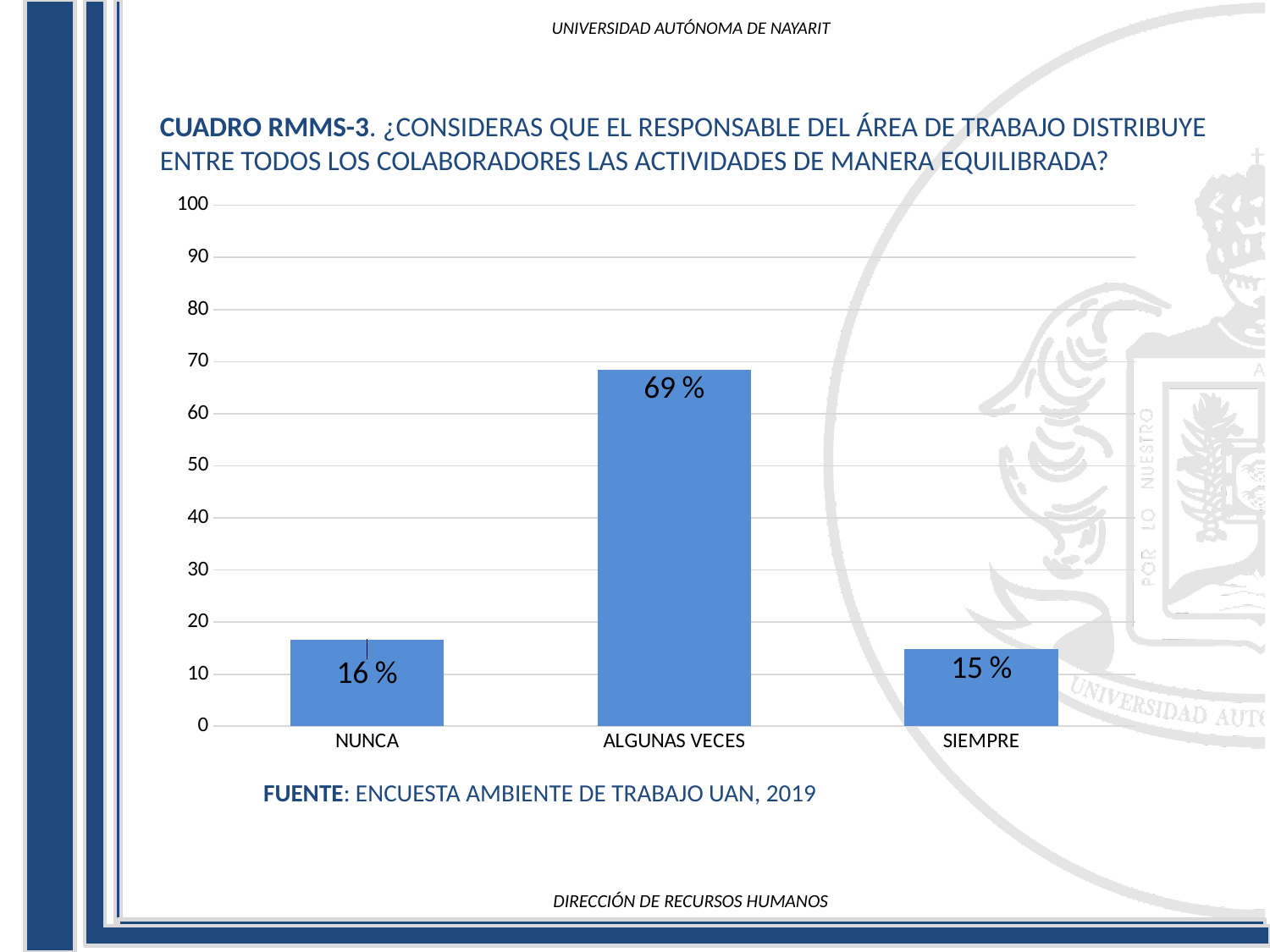
What is the difference between the values for NUNCA and SIEMPRE? 1 % How many categories are shown on the x axis? 3 What is the value for NUNCA? 16 % Which category has the highest value? ALGUNAS VECES What kind of chart is shown on the slide? bar chart What is the difference between the values for ALGUNAS VECES and NUNCA? 53 % Is the value for ALGUNAS VECES greater or less than 60? greater What is the highest value shown on the y axis? 100 What is the value for SIEMPRE? 15 % What is the source cited below the chart? ENCUESTA AMBIENTE DE TRABAJO UAN, 2019 Is the value for SIEMPRE greater or less than 20? less What is the value for ALGUNAS VECES? 69 %